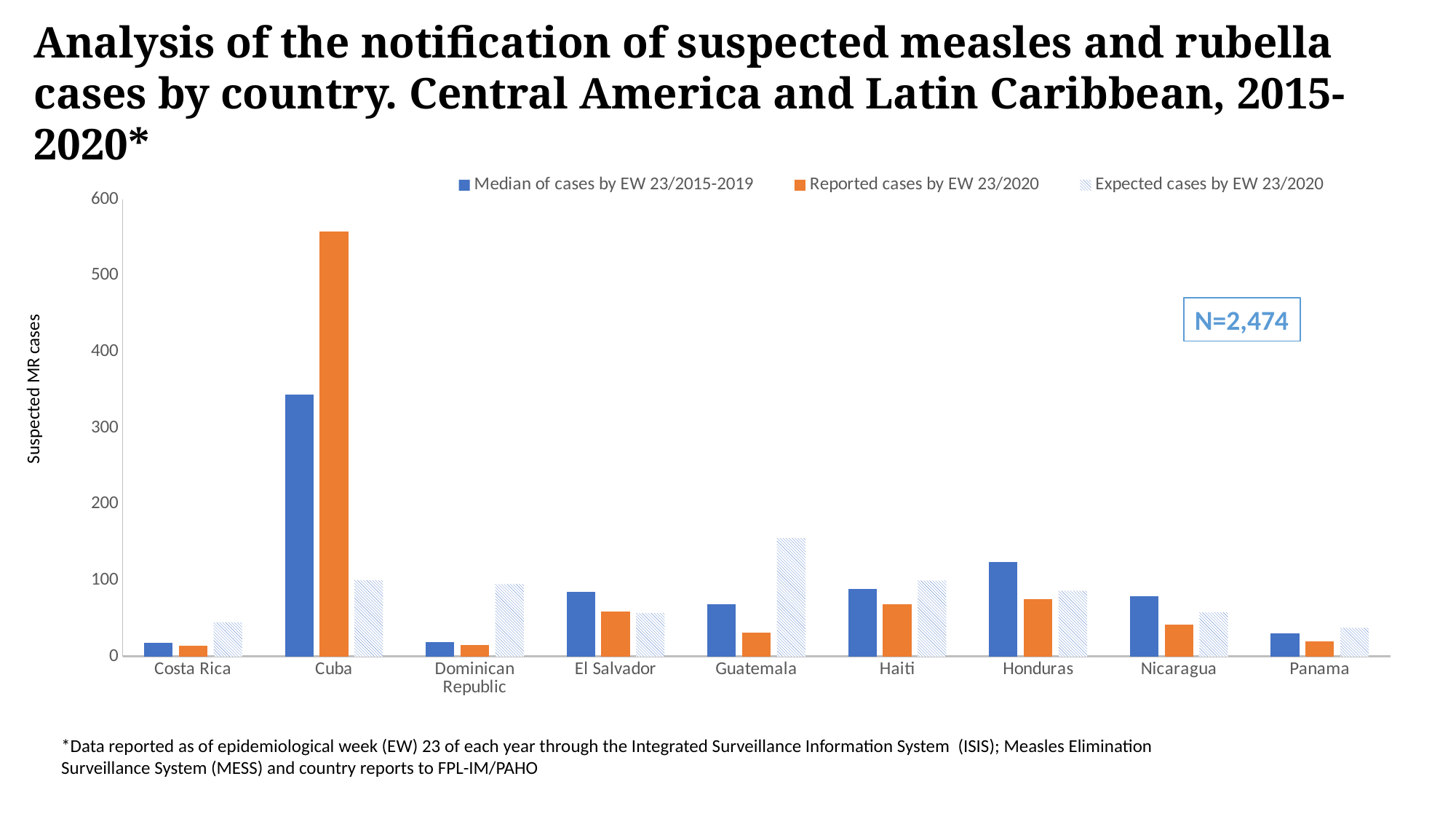
What kind of chart is shown on the slide? Bar chart Is the value for Reported cases by EW 23/2020 for Cuba greater or less than 500? greater What is the N value shown in the box on the chart? N=2,474 Which is larger for Guatemala: Reported cases by EW 23/2020 or Expected cases by EW 23/2020? Expected cases by EW 23/2020 Which country has the highest value for Median of cases by EW 23/2015-2019? Cuba Which country has a larger Median of cases by EW 23/2015-2019: Honduras or Haiti? Honduras Is the value for Median of cases by EW 23/2015-2019 for Honduras greater or less than 100? greater Is the value for Median of cases by EW 23/2015-2019 for Cuba greater or less than 300? greater How many countries are shown on the x axis of the chart? 9 Which country has the highest value for Reported cases by EW 23/2020? Cuba How many series does the chart's legend list? 3